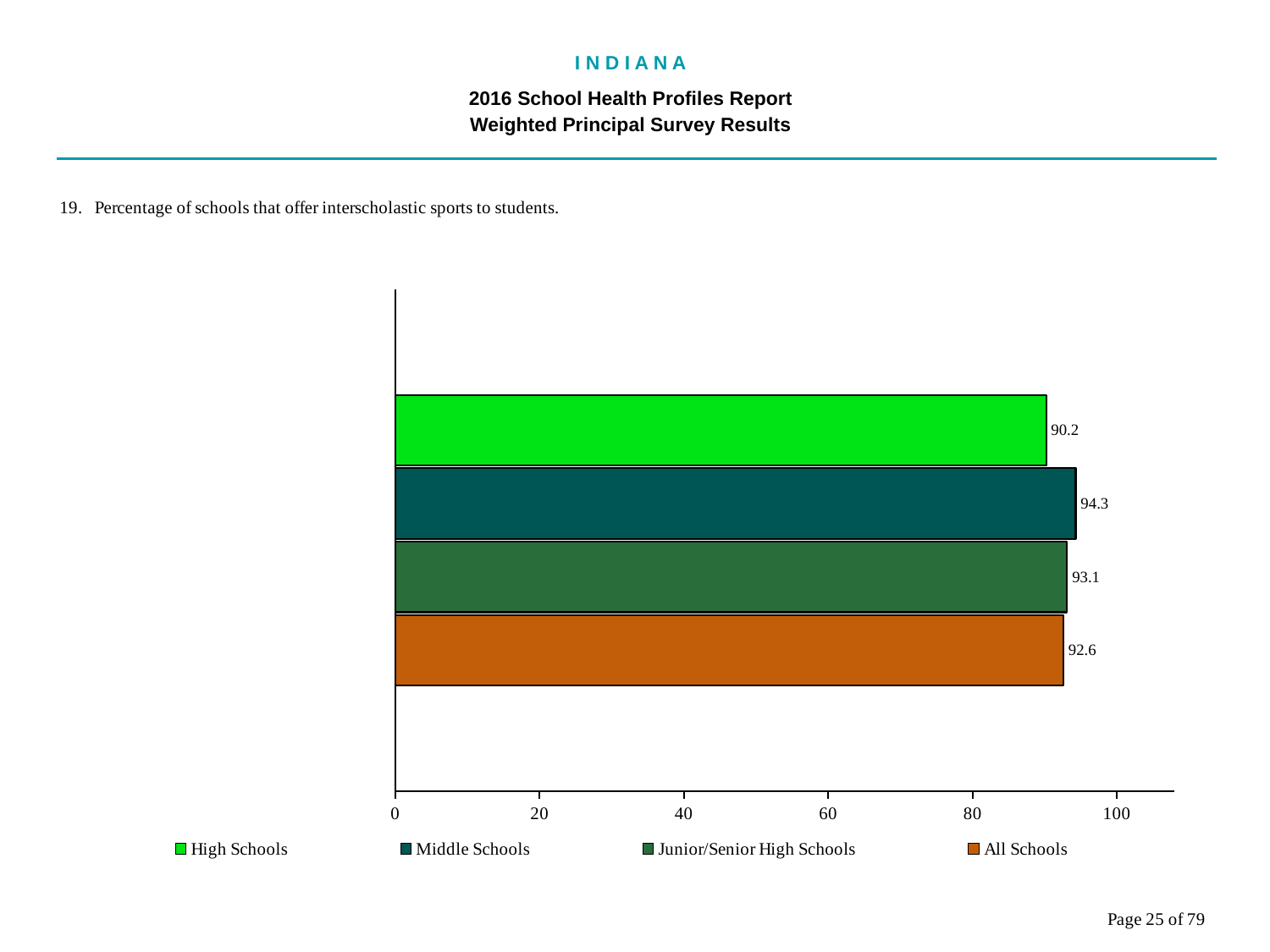
What is the value for High Schools? 90.2 Which school type has the highest value? Middle Schools How many entries does the legend list? 4 What is the difference between the values for Junior/Senior High Schools and All Schools? 0.5 Which is larger, the value for Middle Schools or the value for All Schools? Middle Schools What is the value for Junior/Senior High Schools? 93.1 How many bars are shown in the chart? 4 What is the difference between the values for Middle Schools and High Schools? 4.1 What is the value for Middle Schools? 94.3 What is the value for All Schools? 92.6 Which school type has the lowest value? High Schools What kind of chart is shown on the slide? Bar chart